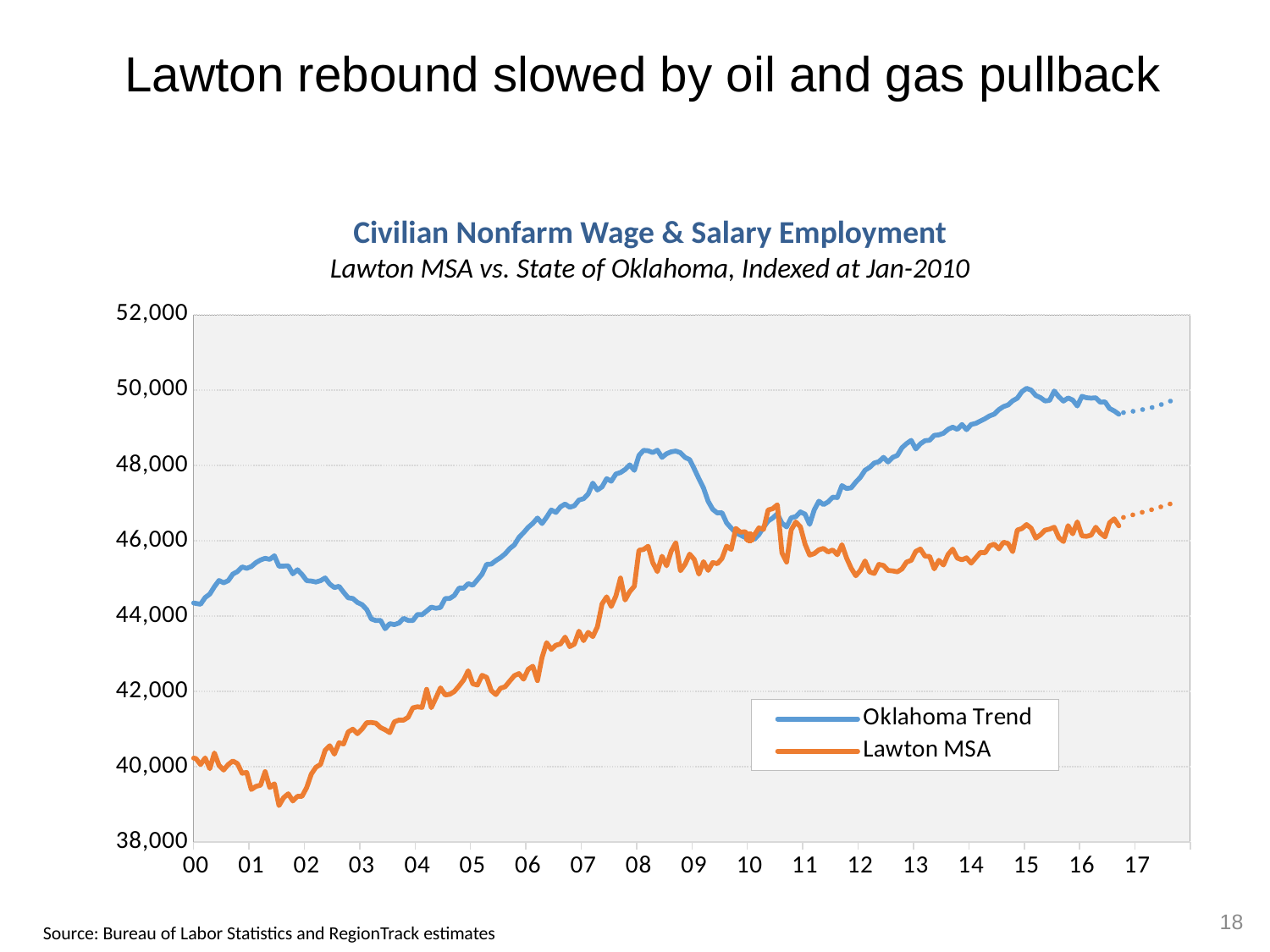
How many year labels are shown on the x axis? 18 Does the Oklahoma Trend series rise or fall between 2008 and 2009? fall Which series is drawn in orange? Lawton MSA How many series does the legend list? 2 Is the Oklahoma Trend value at the start of 2003 greater or less than 46,000? less At the start of 2005, which series has the higher value, Oklahoma Trend or Lawton MSA? Oklahoma Trend What is the title of the chart? Civilian Nonfarm Wage & Salary Employment Is the Oklahoma Trend value at the start of 2012 greater or less than 46,000? greater Is the Lawton MSA value at the start of 2002 greater or less than 40,000? less Does the Lawton MSA series overall rise or fall from 2000 to 2017? rise What kind of chart is shown on the slide? line chart